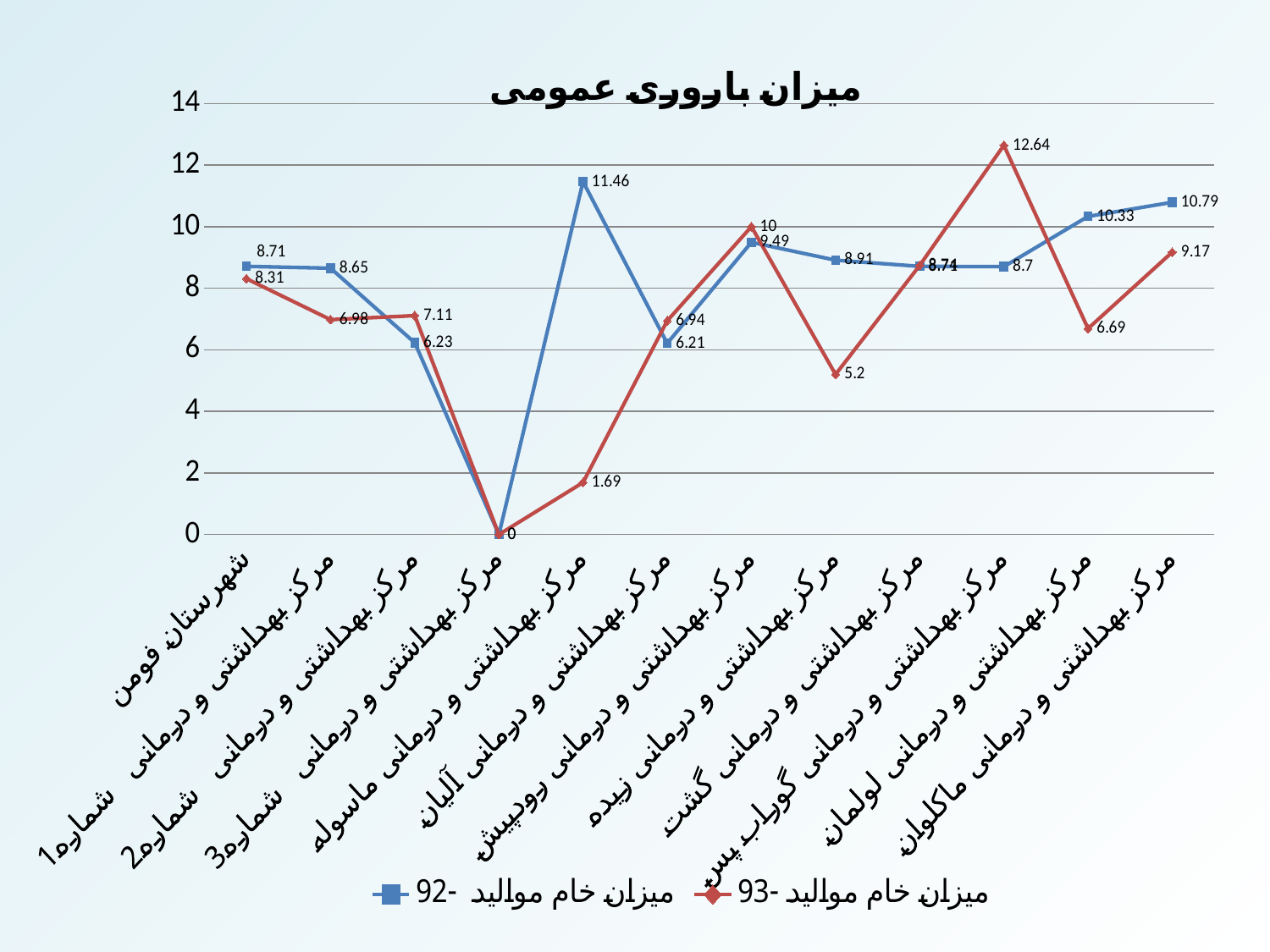
What is the value of the 92 series (میزان خام موالید -92) for شهرستان فومن? 8.71 What is the value of the 92 series for مرکز بهداشتی و درمانی آلیان? 6.21 What is the difference between the 92 and 93 series values for مرکز بهداشتی و درمانی آلیان? 0.73 What type of chart is shown on the slide? line chart What is the difference between the 92 series values for مرکز بهداشتی و درمانی ماکلوان and مرکز بهداشتی و درمانی لولمان? 0.46 What is the value of the 93 series (میزان خام موالید -93) for مرکز بهداشتی و درمانی لولمان? 6.69 For مرکز بهداشتی و درمانی زیده, which series has the larger value, 92 or 93? 92 What is the title of the chart? میزان باروری عمومی Which category has the highest value in the 93 series? مرکز بهداشتی و درمانی گوراب پس How many series does the legend list? 2 How many categories are plotted along the x axis? 12 Which category has the lowest value in the 92 series? مرکز بهداشتی و درمانی شماره 3